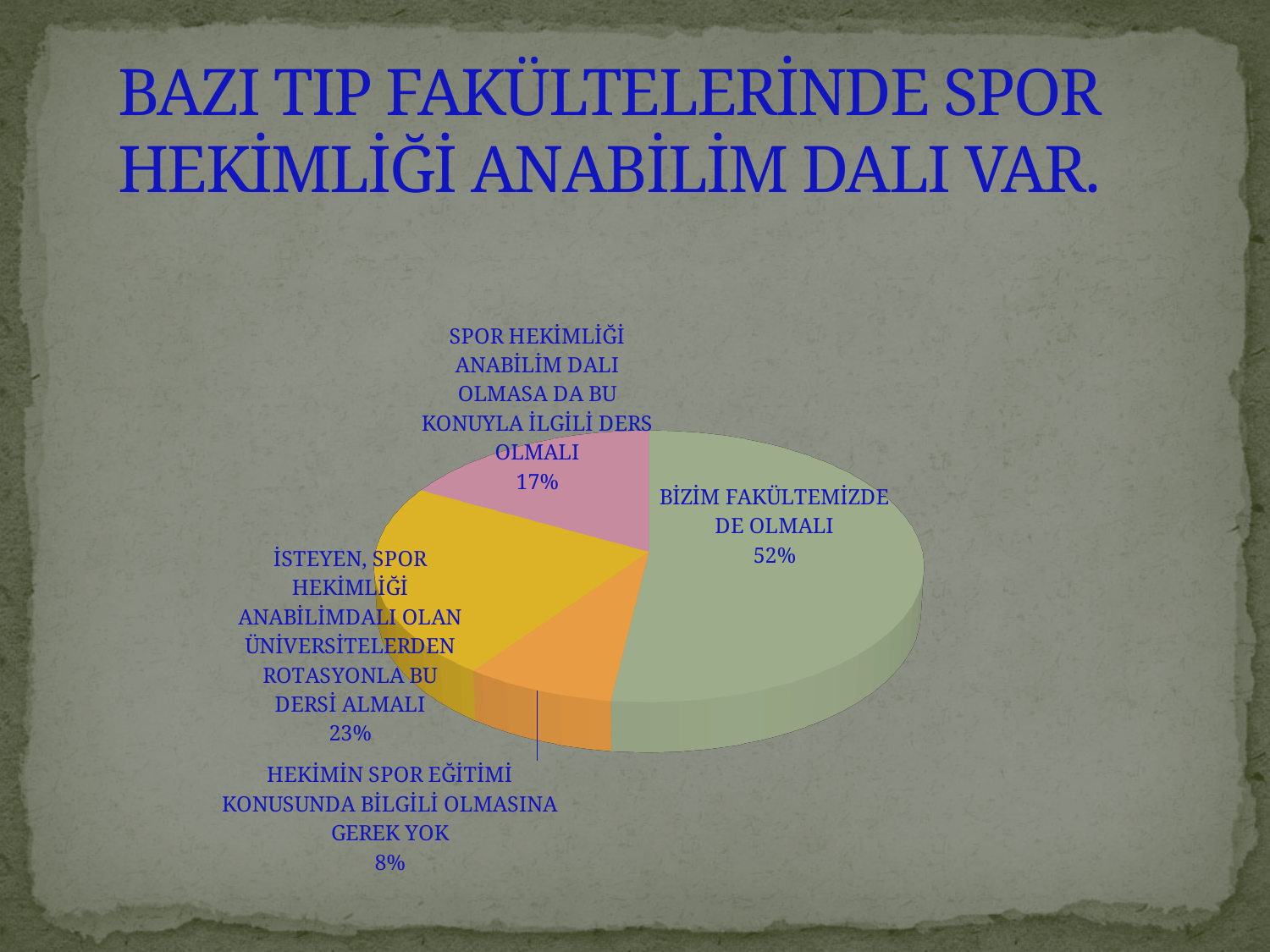
What colour is the slice labelled "BİZİM FAKÜLTEMİZDE DE OLMALI"? Green What percentage is shown for the slice labelled "HEKİMİN SPOR EĞİTİMİ KONUSUNDA BİLGİLİ OLMASINA GEREK YOK"? 8% Which slice of the pie chart has the largest share? BİZİM FAKÜLTEMİZDE DE OLMALI What percentage is shown for the slice labelled "İSTEYEN, SPOR HEKİMLİĞİ ANABİLİMDALI OLAN ÜNİVERSİTELERDEN ROTASYONLA BU DERSİ ALMALI"? 23% What is the difference in percentage points between the "BİZİM FAKÜLTEMİZDE DE OLMALI" slice and the "İSTEYEN, SPOR HEKİMLİĞİ ANABİLİMDALI OLAN ÜNİVERSİTELERDEN ROTASYONLA BU DERSİ ALMALI" slice? 29 percentage points What is the title of the slide containing the pie chart? BAZI TIP FAKÜLTELERİNDE SPOR HEKİMLİĞİ ANABİLİM DALI VAR. Which slice of the pie chart has the smallest share? HEKİMİN SPOR EĞİTİMİ KONUSUNDA BİLGİLİ OLMASINA GEREK YOK What percentage is shown for the slice labelled "BİZİM FAKÜLTEMİZDE DE OLMALI"? 52% What kind of chart is shown on the slide? Pie chart What percentage is shown for the slice labelled "SPOR HEKİMLİĞİ ANABİLİM DALI OLMASA DA BU KONUYLA İLGİLİ DERS OLMALI"? 17% Which slice is larger: "SPOR HEKİMLİĞİ ANABİLİM DALI OLMASA DA BU KONUYLA İLGİLİ DERS OLMALI" or "HEKİMİN SPOR EĞİTİMİ KONUSUNDA BİLGİLİ OLMASINA GEREK YOK"? SPOR HEKİMLİĞİ ANABİLİM DALI OLMASA DA BU KONUYLA İLGİLİ DERS OLMALI How many slices does the pie chart have? 4